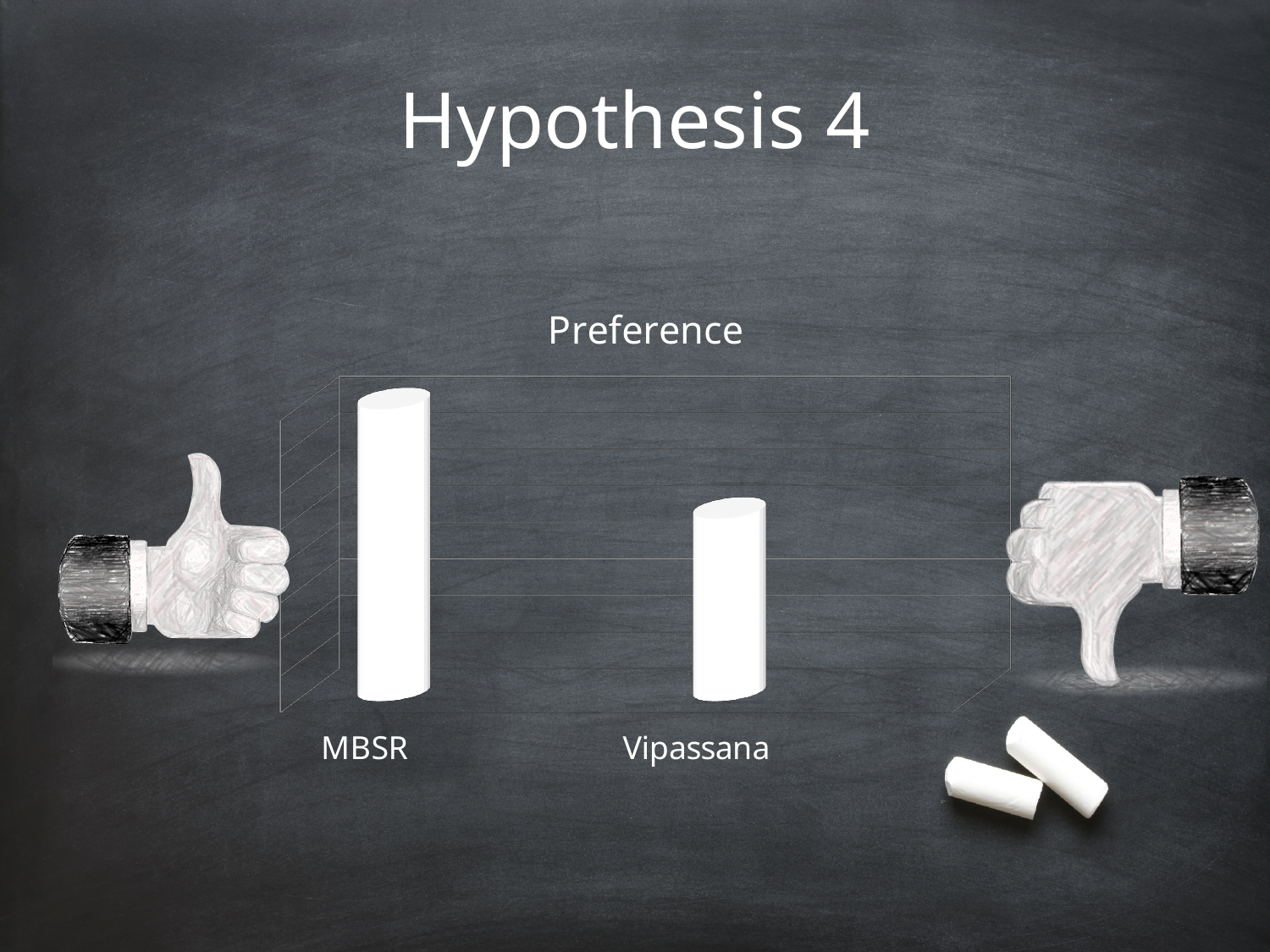
Which category has the lowest value in the Preference chart? Vipassana How many categories are plotted in the Preference chart? 2 What kind of chart is shown on the slide? Bar chart In the Preference chart, which is larger, the value for MBSR or the value for Vipassana? MBSR Which category has the highest value in the Preference chart? MBSR Do the values in the Preference chart rise or fall from MBSR to Vipassana? Fall What is the title of the chart? Preference What are the two category labels on the x axis of the Preference chart? MBSR and Vipassana